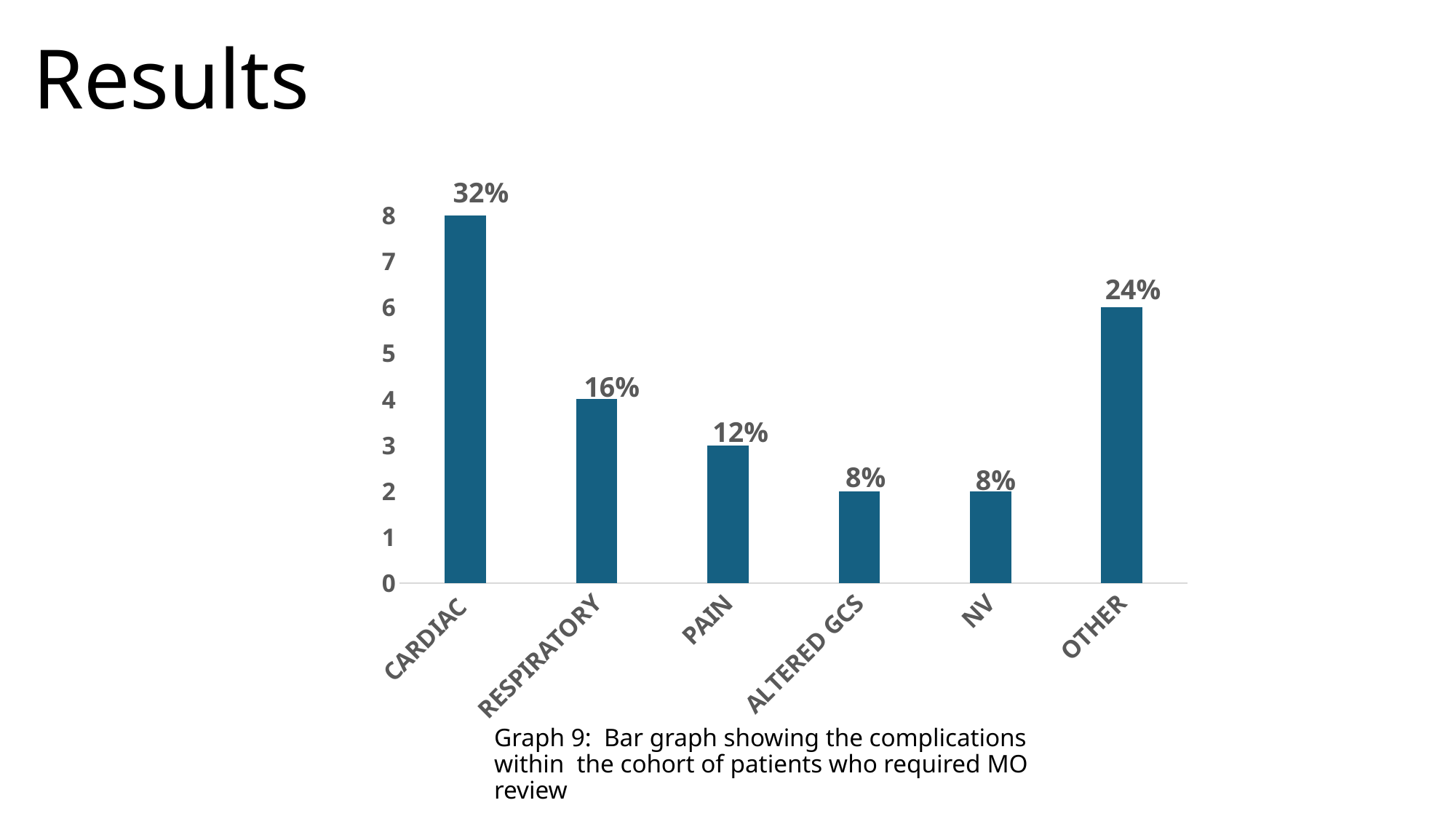
What percentage label is shown for CARDIAC? 32% Which is larger, the value for RESPIRATORY or the value for PAIN? RESPIRATORY How many complication categories are shown on the x axis? 6 What is the graph number given in the caption below the chart? Graph 9 What percentage label is shown for PAIN? 12% Is the value for OTHER greater or less than 5 on the vertical axis? greater What kind of chart is shown on the slide? Bar chart How many patients does the RESPIRATORY bar reach on the vertical axis? 4 What is the difference in percentage points between CARDIAC and OTHER? 8 Which complication category has the highest bar? CARDIAC What percentage label is shown for OTHER? 24% Which two categories share the lowest value of 8%? ALTERED GCS and NV